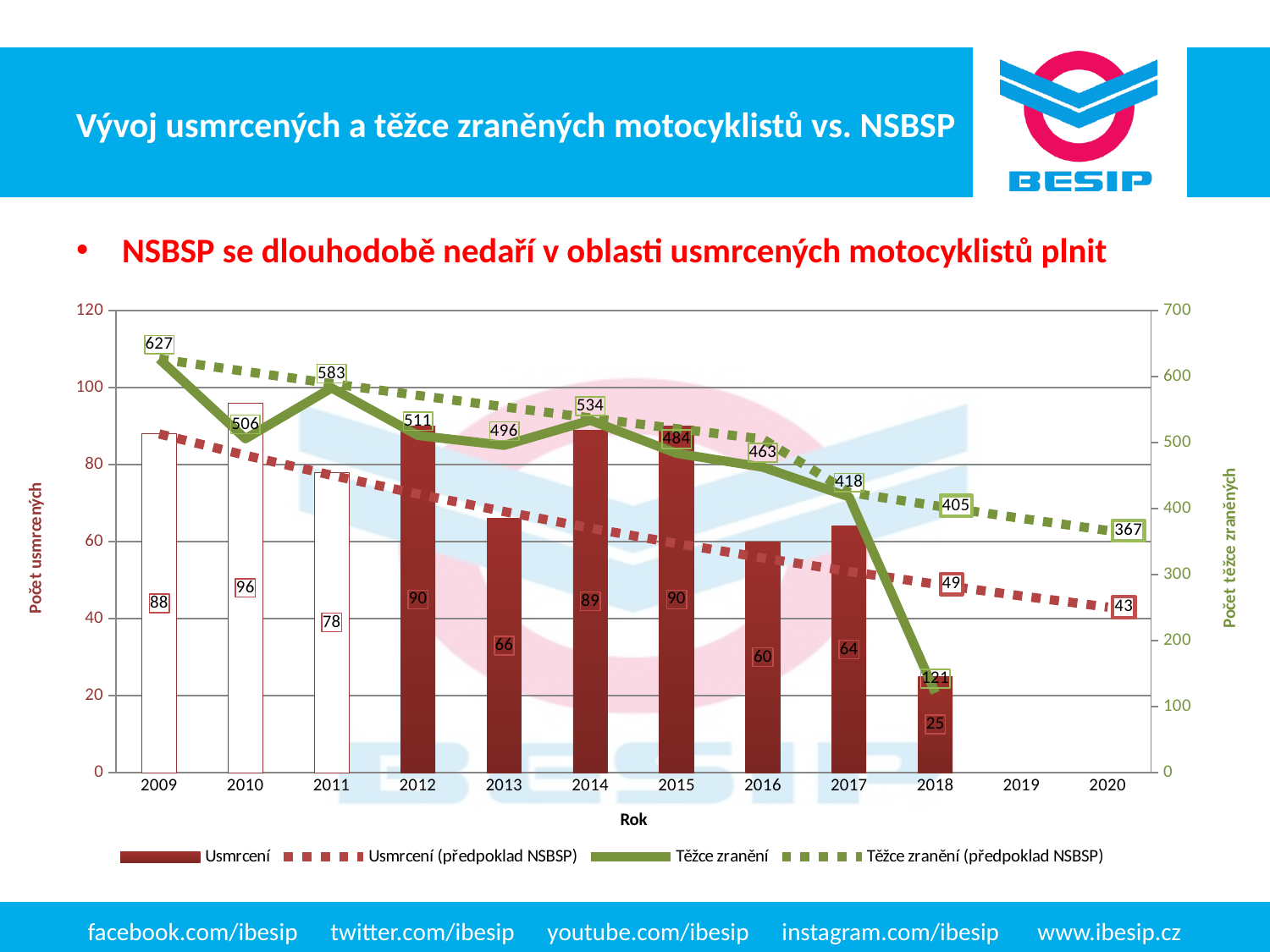
How many series does the legend list? 4 Does the Těžce zranění line rise or fall overall from 2009 to 2018? Fall Which year has the larger Těžce zranění value, 2011 or 2012? 2011 What is the value of Těžce zranění (předpoklad NSBSP) for 2018? 405 What kind of chart is shown on the slide? Combination bar and line chart In which year is the Usmrcení bar lowest? 2018 What is the value of Těžce zranění for 2014? 534 In which year is the Usmrcení bar highest? 2010 What is the value of Usmrcení for 2010? 96 In which year does the Těžce zranění line reach its highest value? 2009 What is the difference between the Usmrcení values for 2009 and 2018? 63 What is the value of Usmrcení (předpoklad NSBSP) for 2020? 43